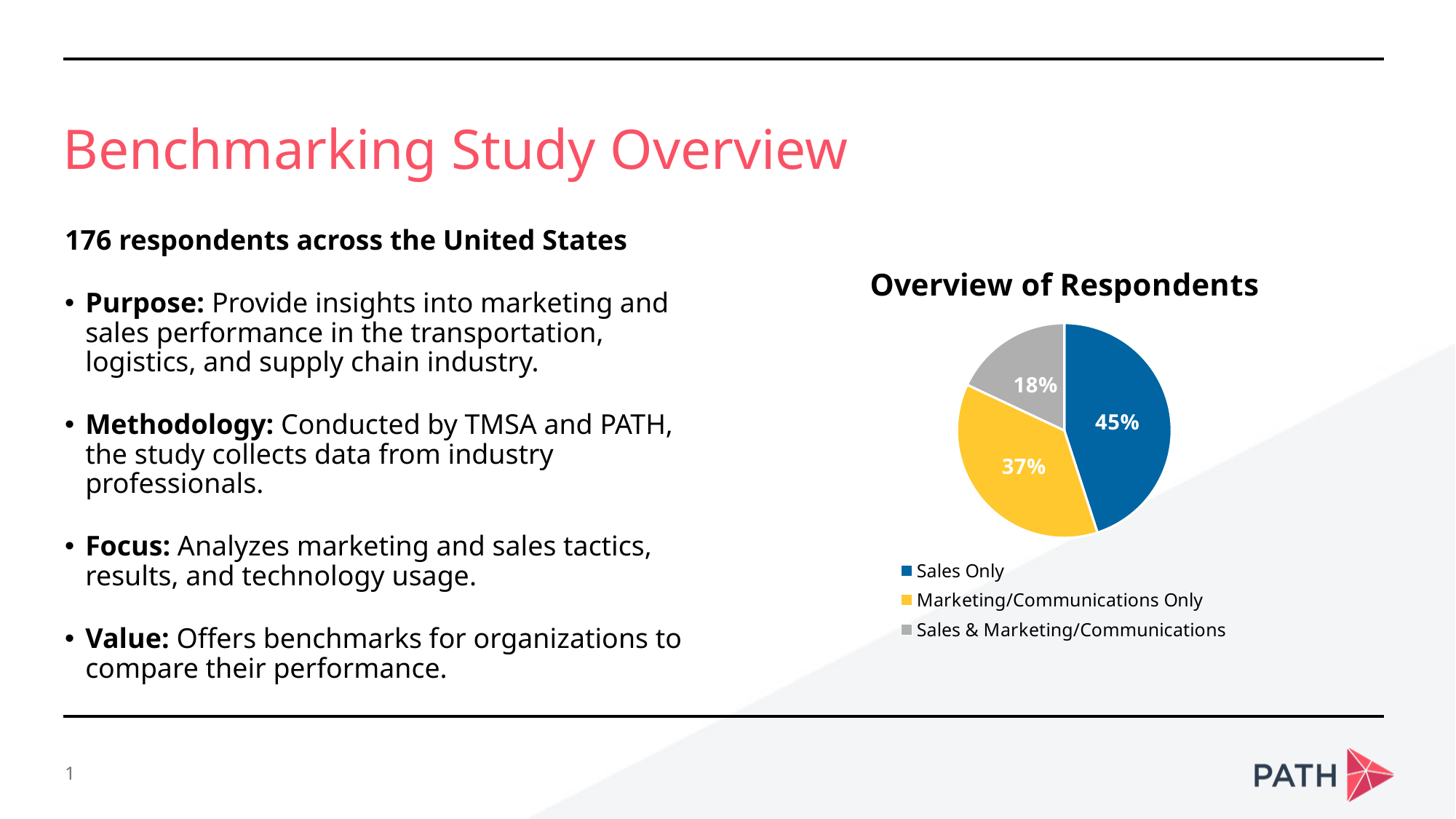
What share of respondents are Sales & Marketing/Communications? 18% Which category has the largest share of respondents? Sales Only How many slices does the pie chart have? 3 Which colour represents Marketing/Communications Only in the chart? Yellow What share of respondents are Marketing/Communications Only? 37% Which category has the smallest share of respondents? Sales & Marketing/Communications Which is larger, the share for Sales Only or the share for Sales & Marketing/Communications? Sales Only What is the difference in percentage points between Sales Only and Marketing/Communications Only? 8 What is the difference in percentage points between Marketing/Communications Only and Sales & Marketing/Communications? 19 What is the title of the chart? Overview of Respondents What kind of chart is shown on the slide? Pie chart What share of respondents are Sales Only? 45%